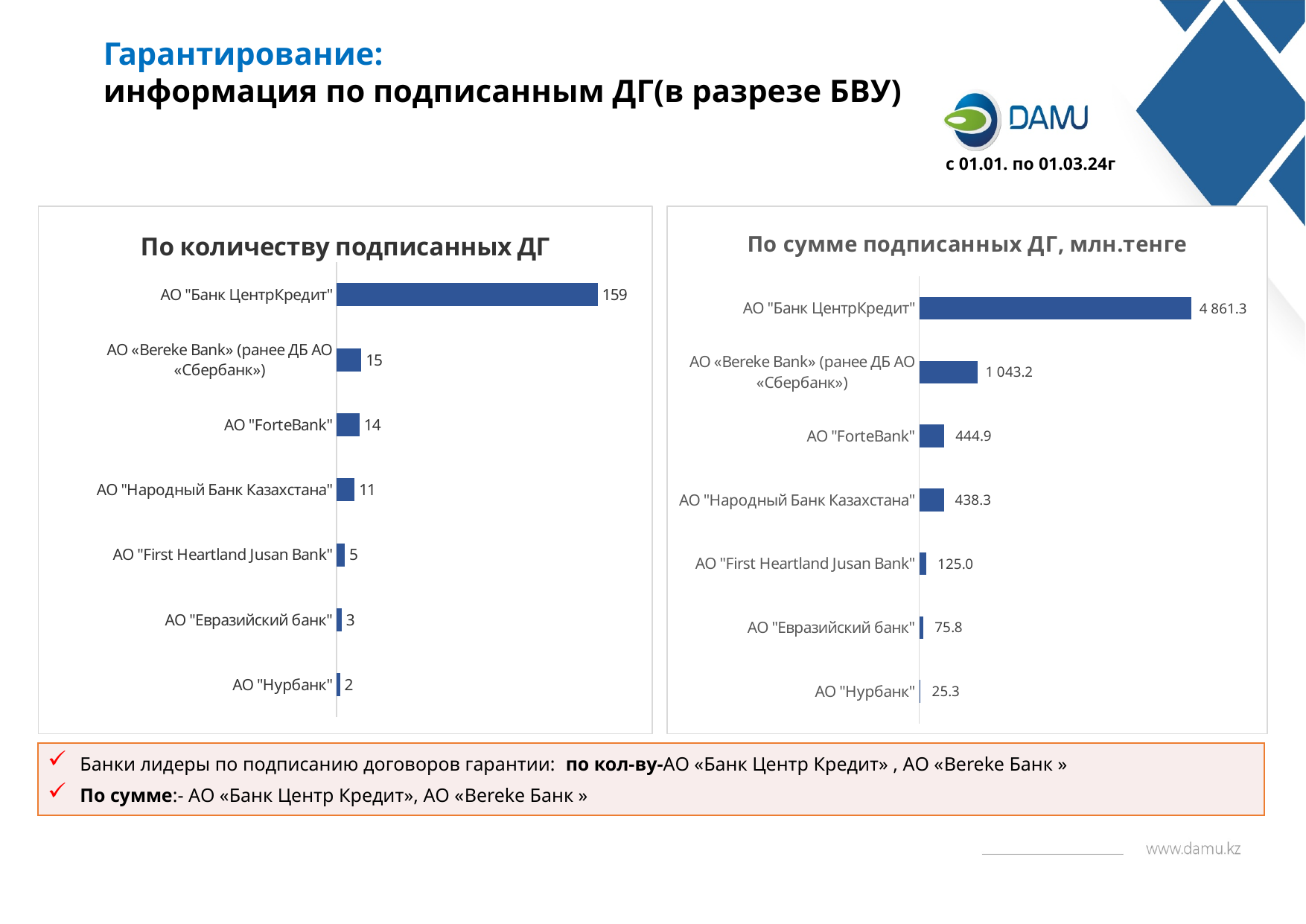
In the chart "По количеству подписанных ДГ", which bank has the lowest value? АО "Нурбанк" In the chart "По количеству подписанных ДГ", what is the value for АО "Банк ЦентрКредит"? 159 How many banks are shown in the chart "По количеству подписанных ДГ"? 7 In the chart "По сумме подписанных ДГ, млн.тенге", what is the value for АО "Нурбанк"? 25.3 What type of chart is "По сумме подписанных ДГ, млн.тенге"? Bar chart In the chart "По количеству подписанных ДГ", which is larger: АО "ForteBank" or АО "Народный Банк Казахстана"? АО "ForteBank" In the chart "По сумме подписанных ДГ, млн.тенге", what is the value for АО "ForteBank"? 444.9 What is the title of the left chart on the slide? По количеству подписанных ДГ In the chart "По количеству подписанных ДГ", what is the difference between АО "Банк ЦентрКредит" and АО «Bereke Bank» (ранее ДБ АО «Сбербанк»)? 144 In the chart "По сумме подписанных ДГ, млн.тенге", which bank has the highest value? АО "Банк ЦентрКредит" In the chart "По сумме подписанных ДГ, млн.тенге", which is larger: АО "First Heartland Jusan Bank" or АО "Евразийский банк"? АО "First Heartland Jusan Bank" In the chart "По сумме подписанных ДГ, млн.тенге", what is the difference between АО "ForteBank" and АО "Народный Банк Казахстана"? 6.6